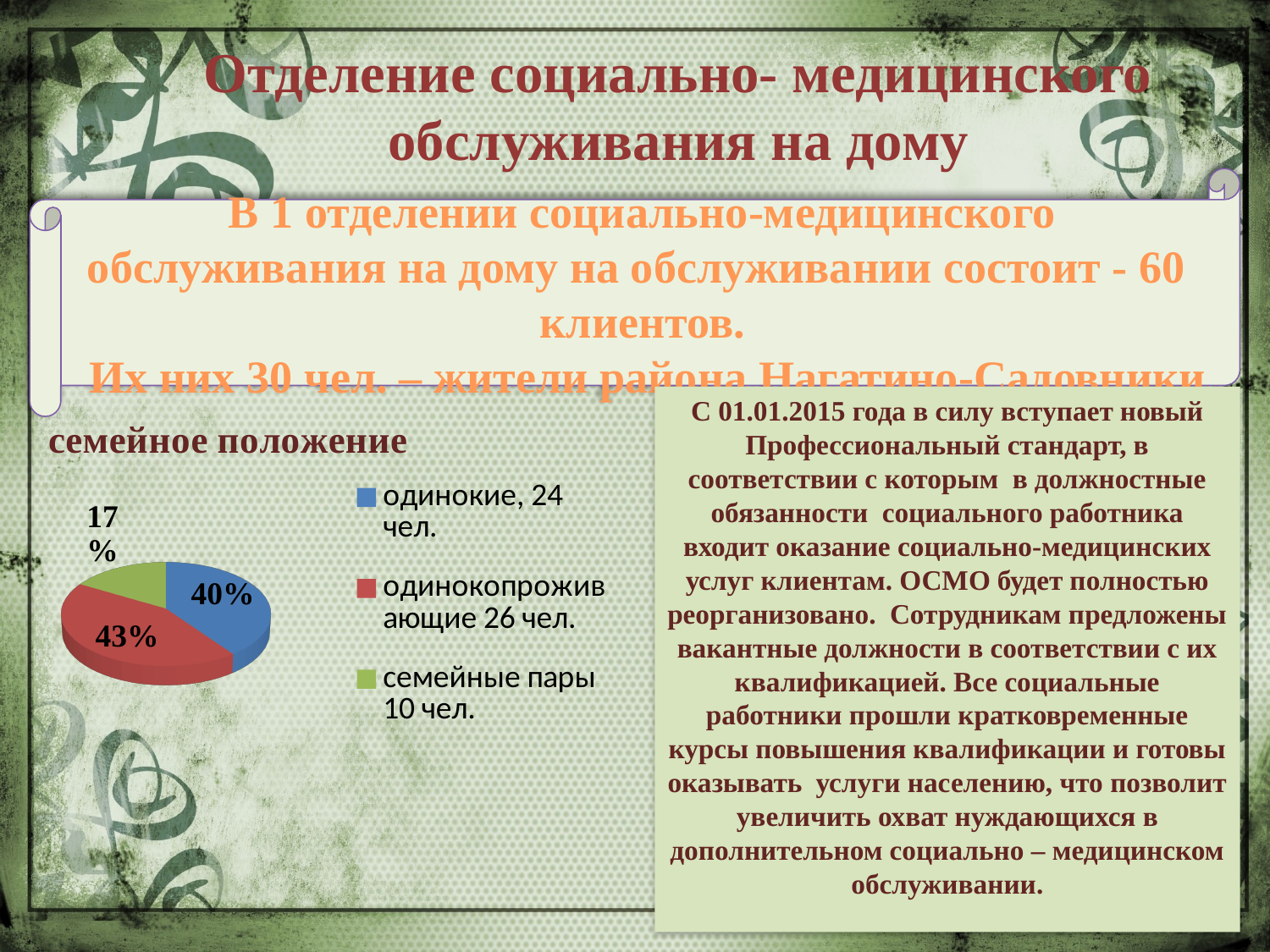
What is the title of the pie chart? семейное положение How many slices does the pie chart have? 3 How many entries does the legend of the pie chart list? 3 What percentage of the pie is labelled for the blue slice (одинокие, 24 чел.)? 40% What kind of chart is shown under the heading "семейное положение"? pie chart What colour is the slice for семейные пары 10 чел.? green What percentage of the pie is labelled for the red slice (одинокопроживающие 26 чел.)? 43% Which slice is larger: одинокие (40%) or семейные пары (17%)? одинокие What is the difference in percentage points between the red slice (43%) and the green slice (17%)? 26 Which category has the smallest share of the pie? семейные пары 10 чел. What percentage of the pie is labelled for the green slice (семейные пары 10 чел.)? 17% Which category has the largest share of the pie? одинокопроживающие 26 чел.